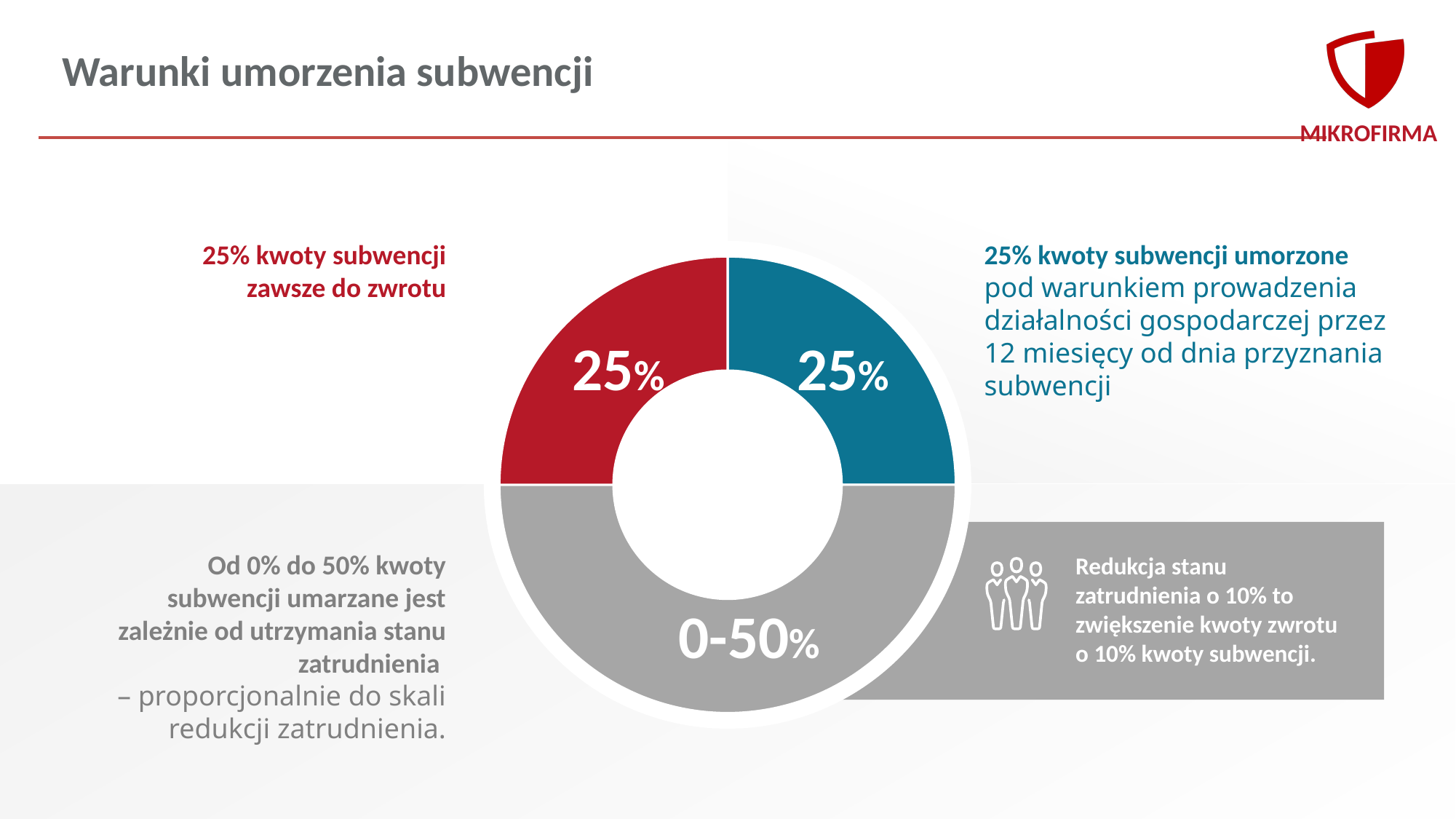
Which segment of the donut chart is the largest? the grey segment (0-50%) What share of the subsidy is always to be repaid, according to the red segment? 25% Is the value of the blue segment greater or less than 50%? less Which colour is the segment labelled '25% kwoty subwencji zawsze do zwrotu'? red How many segments does the donut chart have? 3 What is the title of the slide containing the donut chart? Warunki umorzenia subwencji What value is printed on the blue segment of the donut chart? 25% What value is printed on the red segment of the donut chart? 25% What value is printed on the grey segment of the donut chart? 0-50% What kind of chart is shown on the slide? pie chart (donut) Is the value of the red segment greater or less than 50%? less What share of the subsidy is forgiven on condition of running the business for 12 months, according to the blue segment? 25%